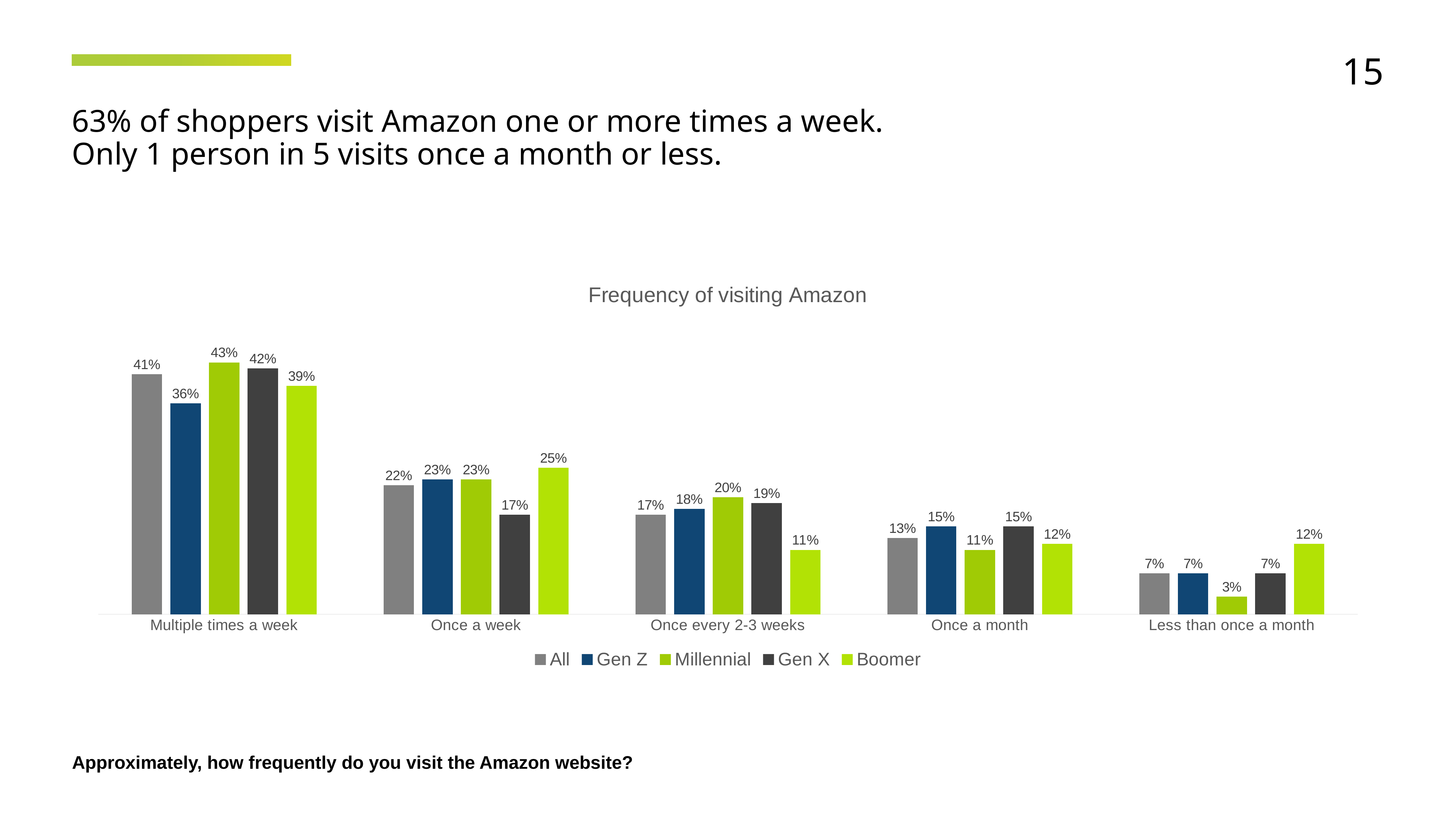
In the 'Once a week' category, which is larger: the Boomer value or the Gen X value? Boomer What is the value for Millennial in the 'Less than once a month' category? 3% How many series does the legend list? 5 What is the value for Gen Z in the 'Multiple times a week' category? 36% What kind of chart is shown on the slide? Bar chart What is the value for Boomer in the 'Once a week' category? 25% Which series has the highest value in the 'Multiple times a week' category? Millennial What is the title of the chart? Frequency of visiting Amazon Which series has the lowest value in the 'Once every 2-3 weeks' category? Boomer What is the difference between the Millennial and Gen Z values in the 'Multiple times a week' category? 7% How many frequency categories are shown on the x axis? 5 Do the values for the 'All' series rise or fall from 'Multiple times a week' to 'Less than once a month'? Fall